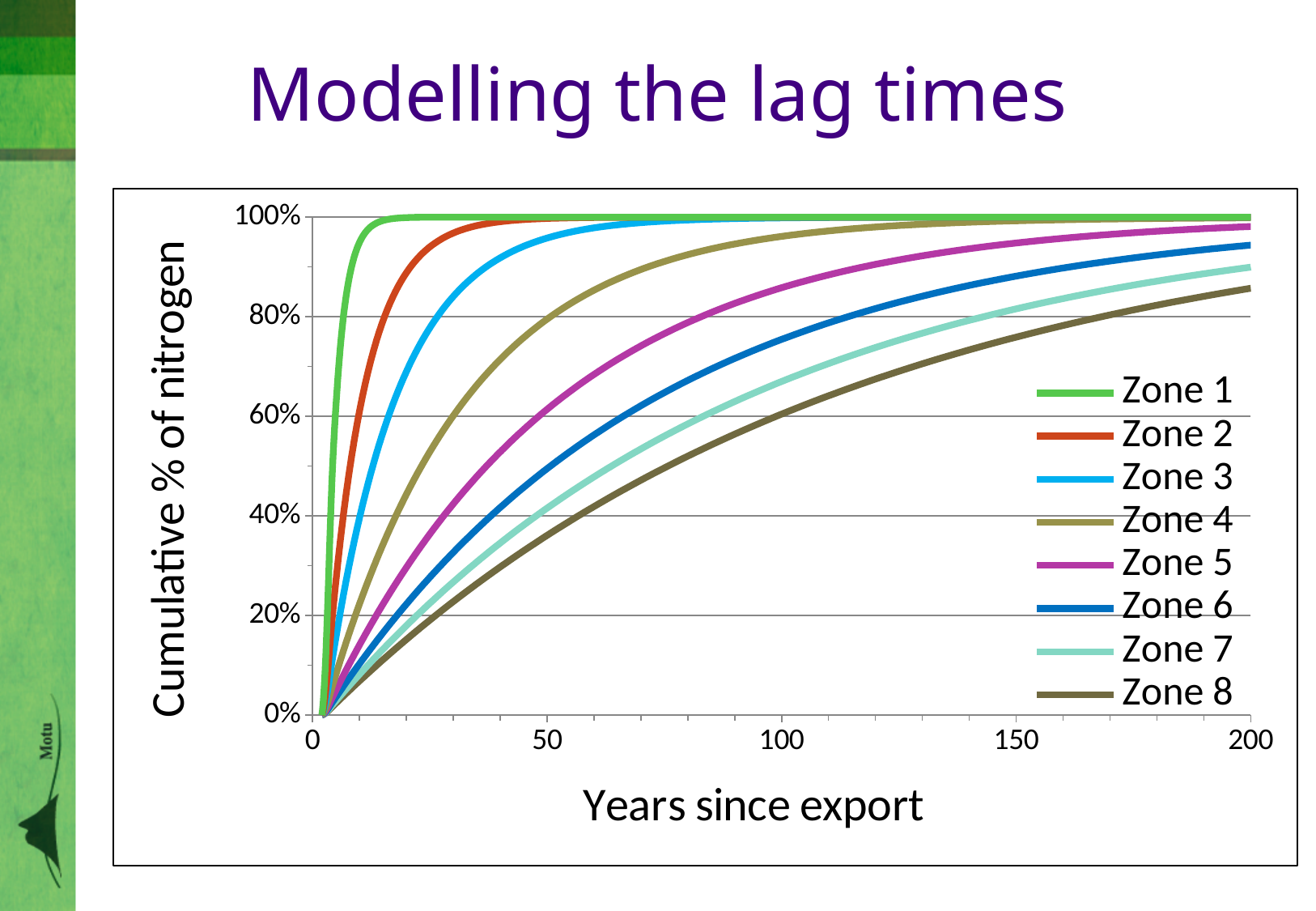
Is the value for Zone 8 at 200 years greater or less than 80%? greater Is the value for Zone 8 at 50 years greater or less than 40%? less How many series does the legend list? 8 Which zone reaches 100% cumulative nitrogen the fastest? Zone 1 Is the value for Zone 3 at 50 years greater or less than 80%? greater At 100 years since export, which is higher: Zone 5 or Zone 8? Zone 5 At 50 years since export, which is higher: Zone 2 or Zone 6? Zone 2 Which zone has the lowest cumulative % of nitrogen at 200 years since export? Zone 8 What is the title of the chart? Modelling the lag times Do the cumulative % of nitrogen values rise or fall as years since export increase? rise What is the label of the x axis? Years since export What kind of chart is shown on the slide? line chart